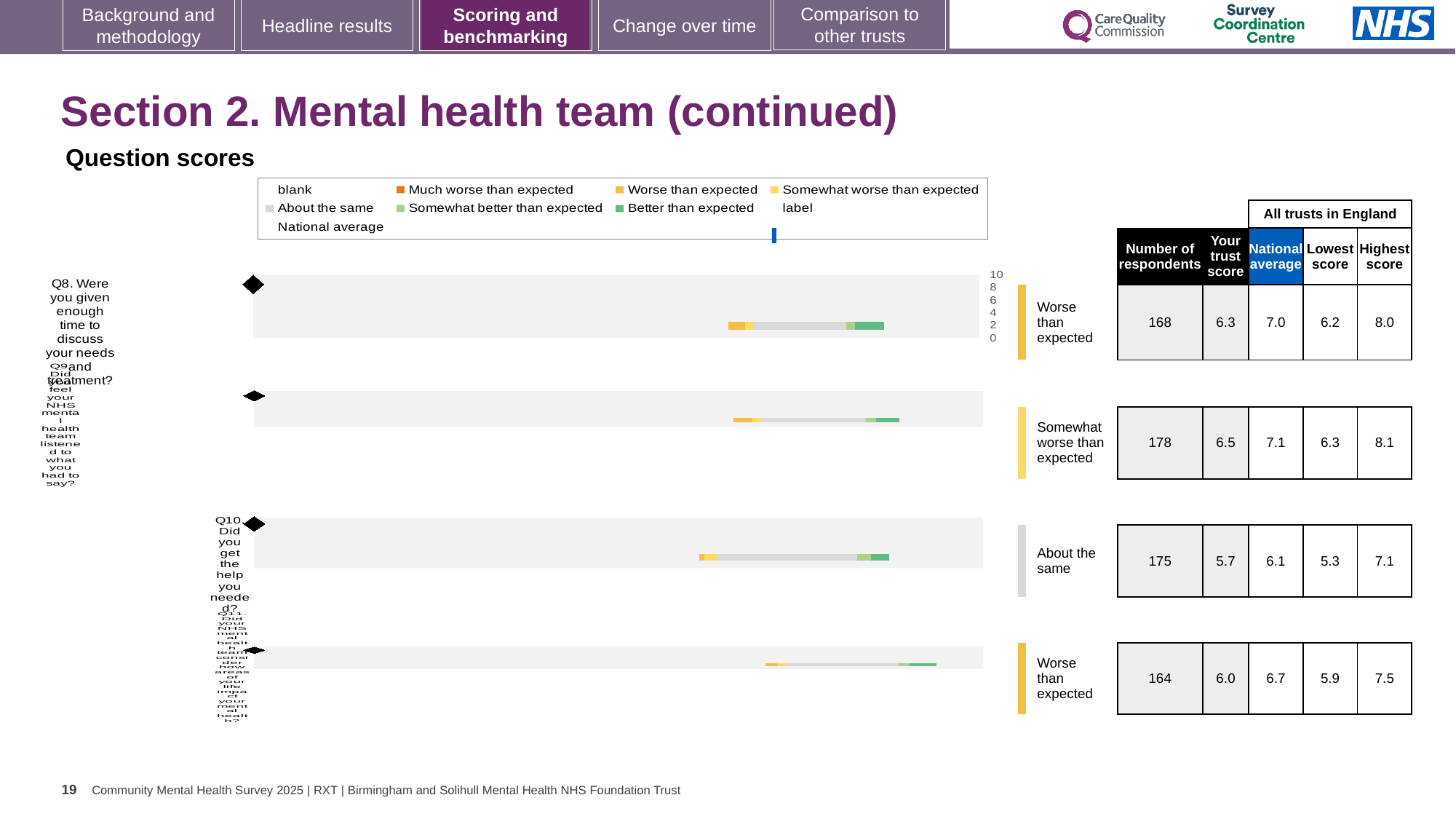
In the table beside the Q9 chart, what is the difference between the highest score and the lowest score? 1.8 What benchmark category is shown next to the Q9 chart? Somewhat worse than expected In the table beside the Q10 chart, what is the national average? 6.1 What is the highest tick value shown on the axis of the Q8 chart? 10 Which legend entry is shown with a blue marker? National average What benchmark category is shown next to the Q8 chart? Worse than expected In the table beside the Q11 chart, how many respondents are listed? 164 What kind of chart is used to show the question scores on this slide? bar chart How many question score charts are shown on the slide? 4 What benchmark category is shown next to the Q11 chart? Worse than expected What benchmark category is shown next to the Q10 chart? About the same In the table beside the Q8 chart, what is the trust score? 6.3